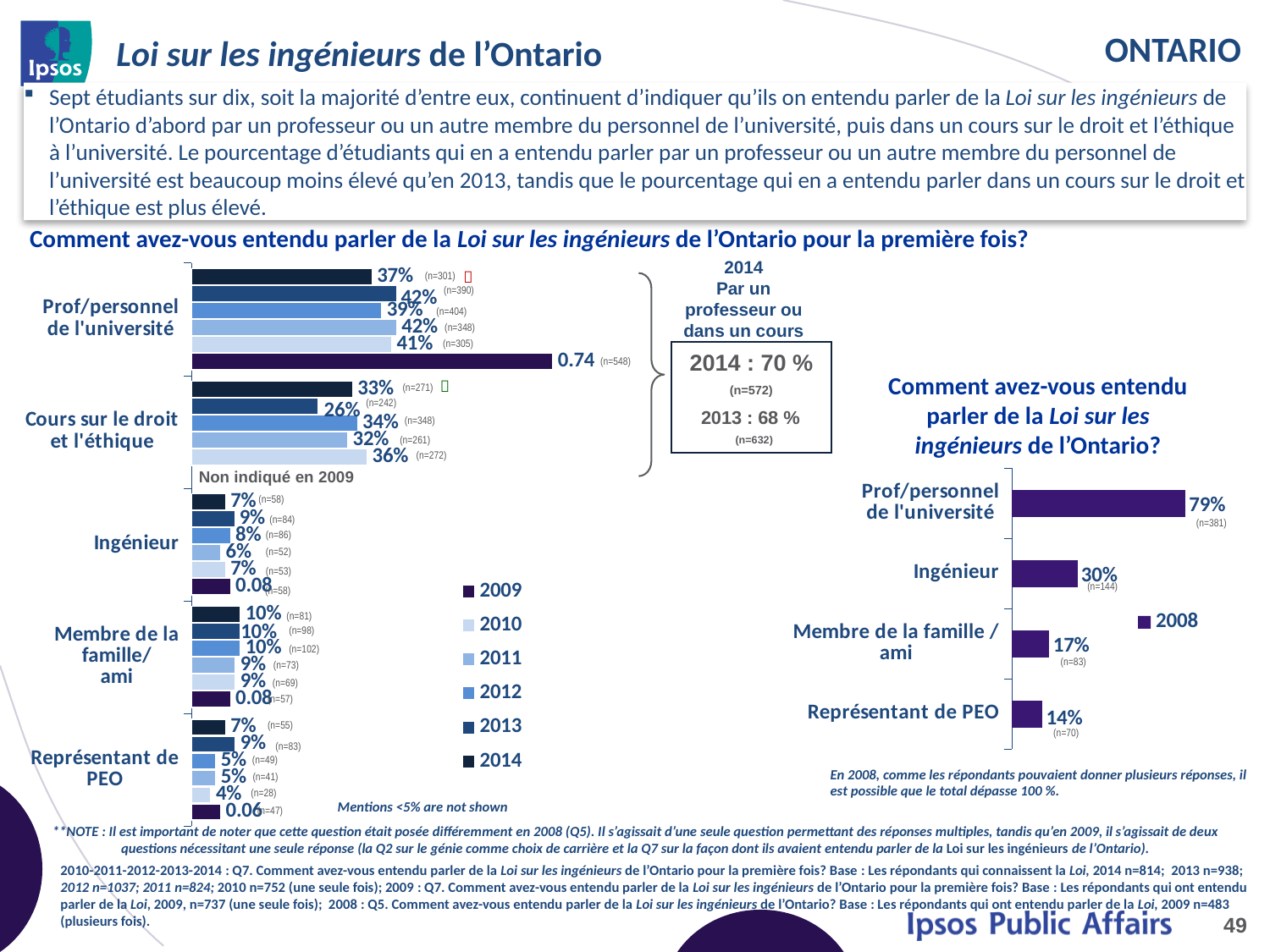
In the right-hand chart, how many series does the legend list? 1 In the right-hand chart, what is the value for Représentant de PEO? 14% In the left-hand chart, how many categories are shown? 5 In the left-hand chart, what is the largest value labelled in the Prof/personnel de l'université group? 0.74 In the right-hand chart (Comment avez-vous entendu parler de la Loi sur les ingénieurs de l'Ontario?), what is the value for Prof/personnel de l'université? 79% In the right-hand chart, which category has the highest value? Prof/personnel de l'université What kind of chart is the right-hand chart? Bar chart In the right-hand chart, which category has the lowest value? Représentant de PEO In the right-hand chart, how many categories are shown? 4 In the left-hand chart (Comment avez-vous entendu parler de la Loi sur les ingénieurs de l'Ontario pour la première fois?), how many series does the legend list? 6 In the left-hand chart, which year does the legend list first? 2009 In the right-hand chart, what is the difference between the values for Ingénieur and Membre de la famille / ami? 13 percentage points